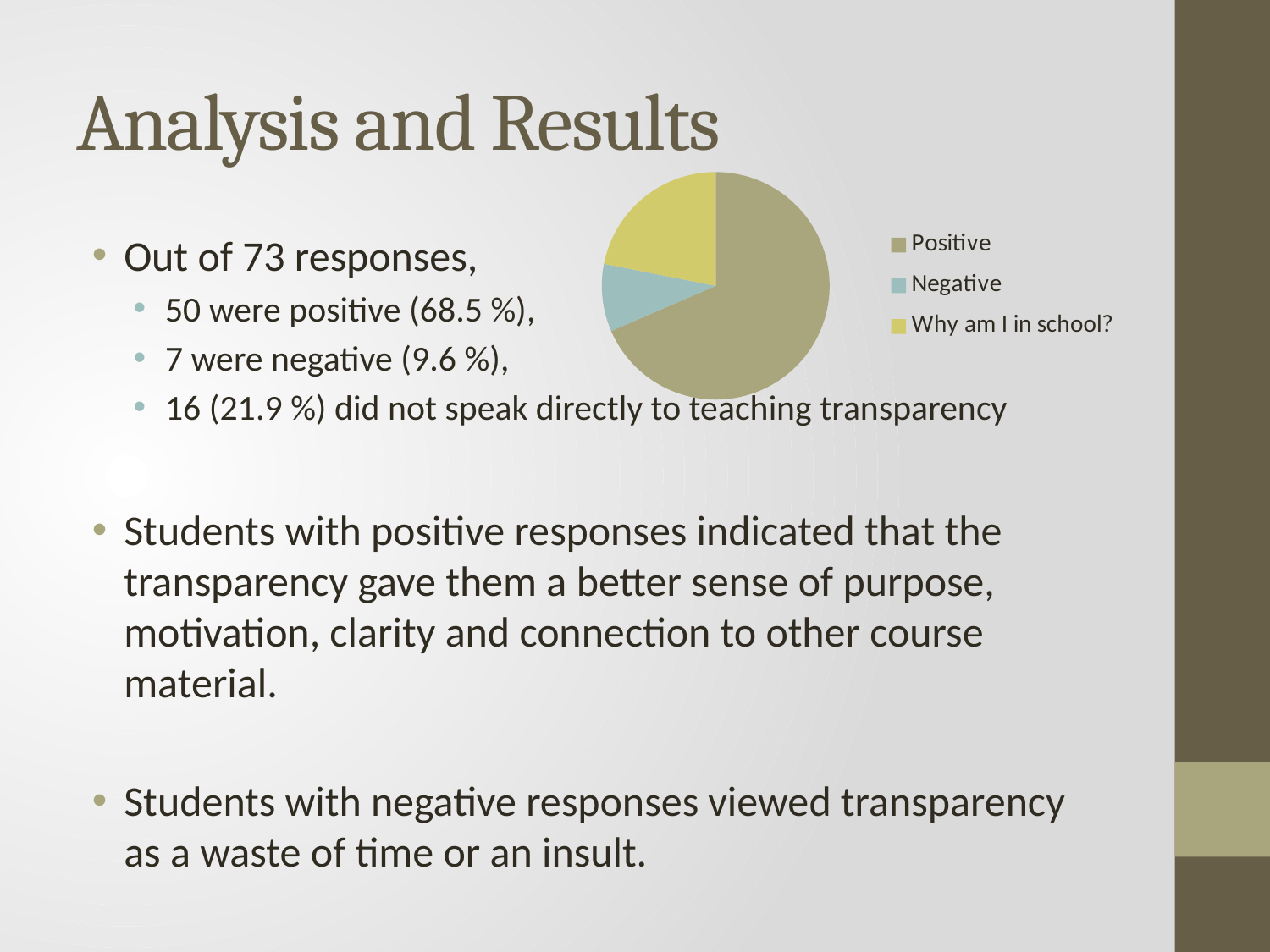
What kind of chart is shown on the slide? pie chart Which category has the largest slice in the pie chart? Positive What is the third legend entry of the pie chart? Why am I in school? How many slices does the pie chart have? 3 What share of the pie does the Negative slice represent? 9.6 % What colour is the Negative slice in the pie chart? light blue How many entries does the legend of the pie chart list? 3 Which slice is larger in the pie chart, Positive or Why am I in school? Positive What share of the pie does the Positive slice represent? 68.5 % Which category has the smallest slice in the pie chart? Negative Which slice is larger in the pie chart, Negative or Why am I in school? Why am I in school?